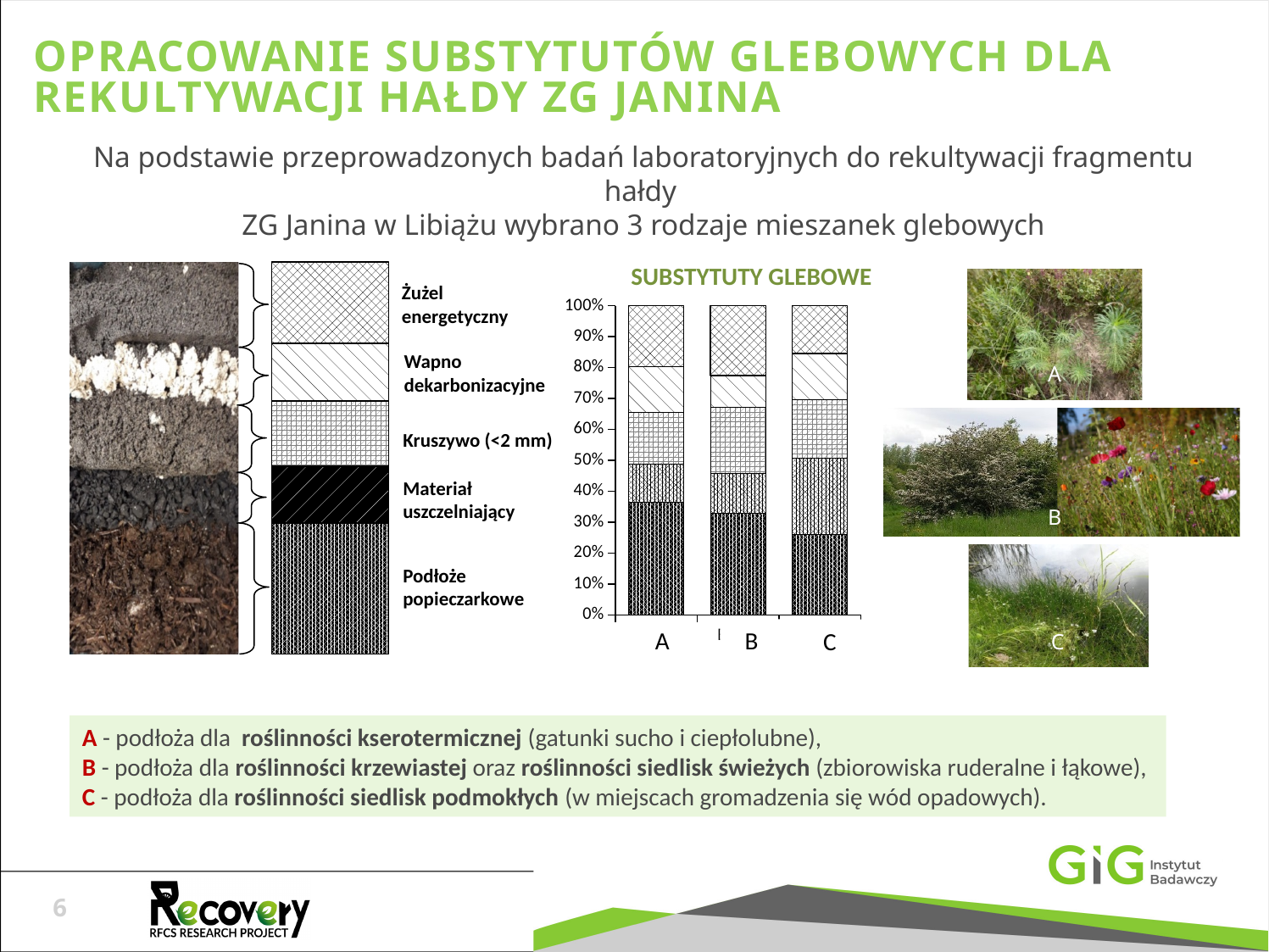
What kind of chart is shown under the title SUBSTYTUTY GLEBOWE? Stacked bar chart In the SUBSTYTUTY GLEBOWE chart, which mixture has the larger share of Materiał uszczelniający, A or C? C How many bars (soil mixtures) are plotted in the SUBSTYTUTY GLEBOWE chart? 3 In the SUBSTYTUTY GLEBOWE chart, is the share of Podłoże popieczarkowe in mixture C greater or less than 30%? less In the SUBSTYTUTY GLEBOWE chart, which mixture has the largest share of Podłoże popieczarkowe? A In the SUBSTYTUTY GLEBOWE chart, what is the total height of bar A? 100% How many components (series) does the pattern key next to the SUBSTYTUTY GLEBOWE chart list? 5 In the SUBSTYTUTY GLEBOWE chart, is the share of Podłoże popieczarkowe in mixture A greater or less than 30%? greater What is the title of the stacked bar chart? SUBSTYTUTY GLEBOWE In the SUBSTYTUTY GLEBOWE chart, which mixture has the smallest share of Podłoże popieczarkowe? C Which component is shown at the bottom of each stacked bar in the SUBSTYTUTY GLEBOWE chart? Podłoże popieczarkowe In the SUBSTYTUTY GLEBOWE chart, which mixture has the smallest share of Żużel energetyczny? C